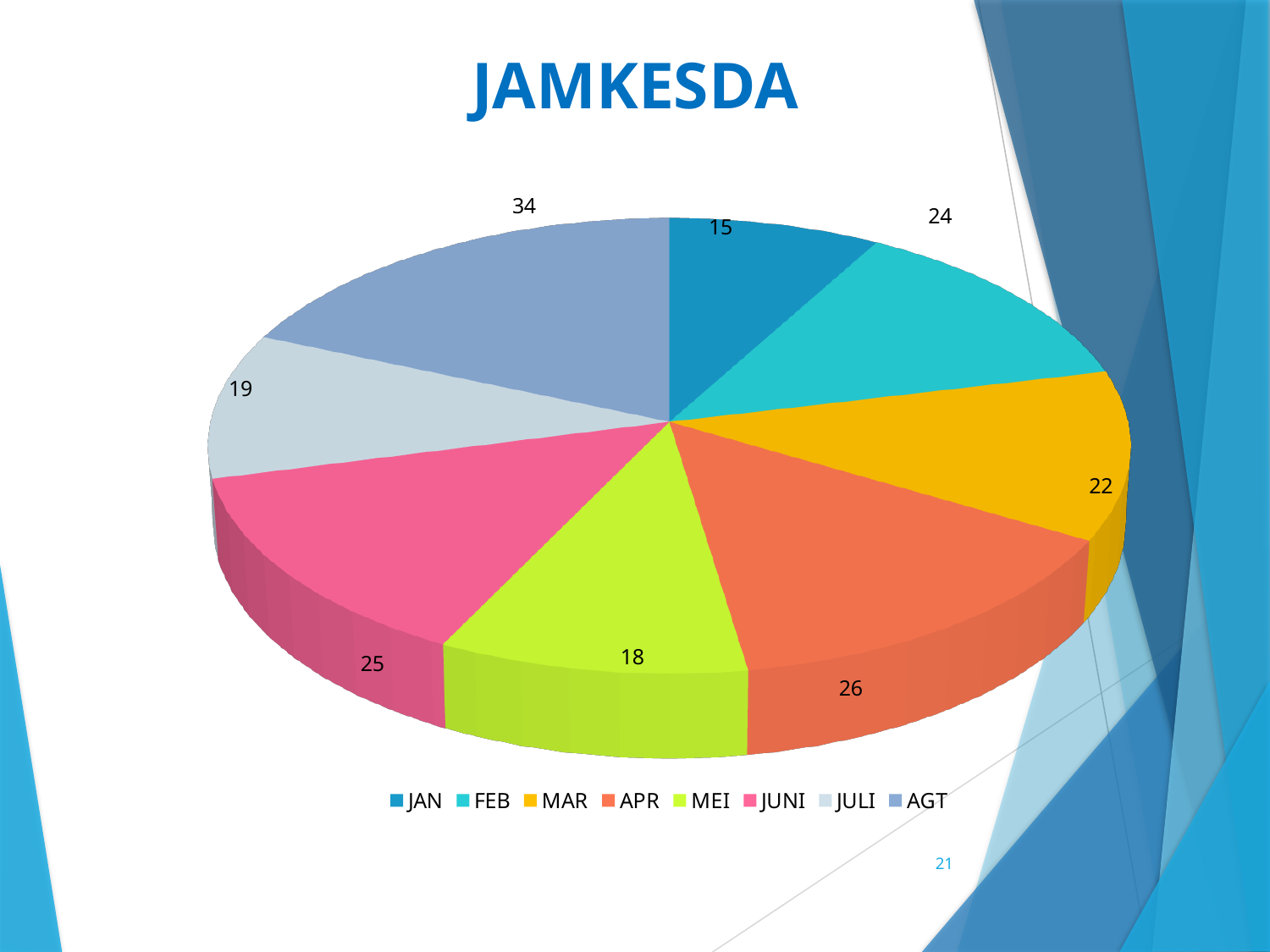
What is the title of the chart on the slide? JAMKESDA What is the difference between the AGT value and the JAN value? 19 Which month has the largest slice in the JAMKESDA pie chart? AGT How much larger is the APR value than the MEI value? 8 What value is labelled on the APR slice? 26 What is the sum of all the slice values in the JAMKESDA pie chart? 183 What is the value shown for JAN in the JAMKESDA chart? 15 How many slices does the JAMKESDA pie chart have? 8 What kind of chart is shown on the slide? Pie chart What is the value of the AGT slice in the JAMKESDA pie chart? 34 Which is larger, the FEB slice or the MAR slice? FEB Which month has the smallest slice in the JAMKESDA pie chart? JAN